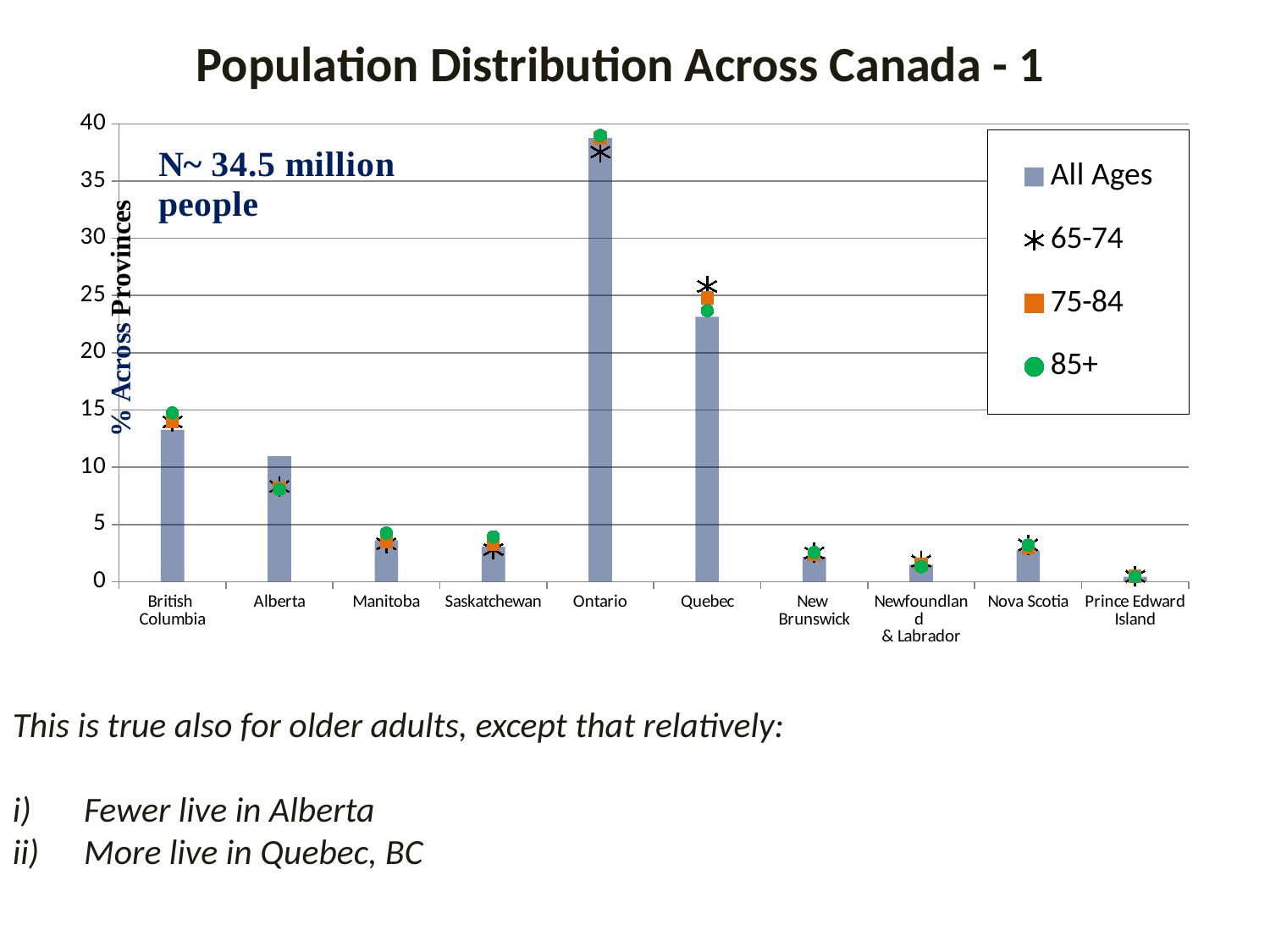
How many series does the legend list? 4 Which province has the highest All Ages value? Ontario Is the All Ages value for British Columbia greater or less than 10? greater Which province has the lowest All Ages value? Prince Edward Island Which has the larger All Ages value, British Columbia or Alberta? British Columbia What is the title of the chart? Population Distribution Across Canada - 1 What kind of chart is shown on the slide? bar chart Which series is shown with a green circle marker in the legend? 85+ Is the All Ages value for Quebec greater or less than 20? greater How many provinces are shown along the x axis? 10 Is the All Ages value for Manitoba greater or less than 5? less